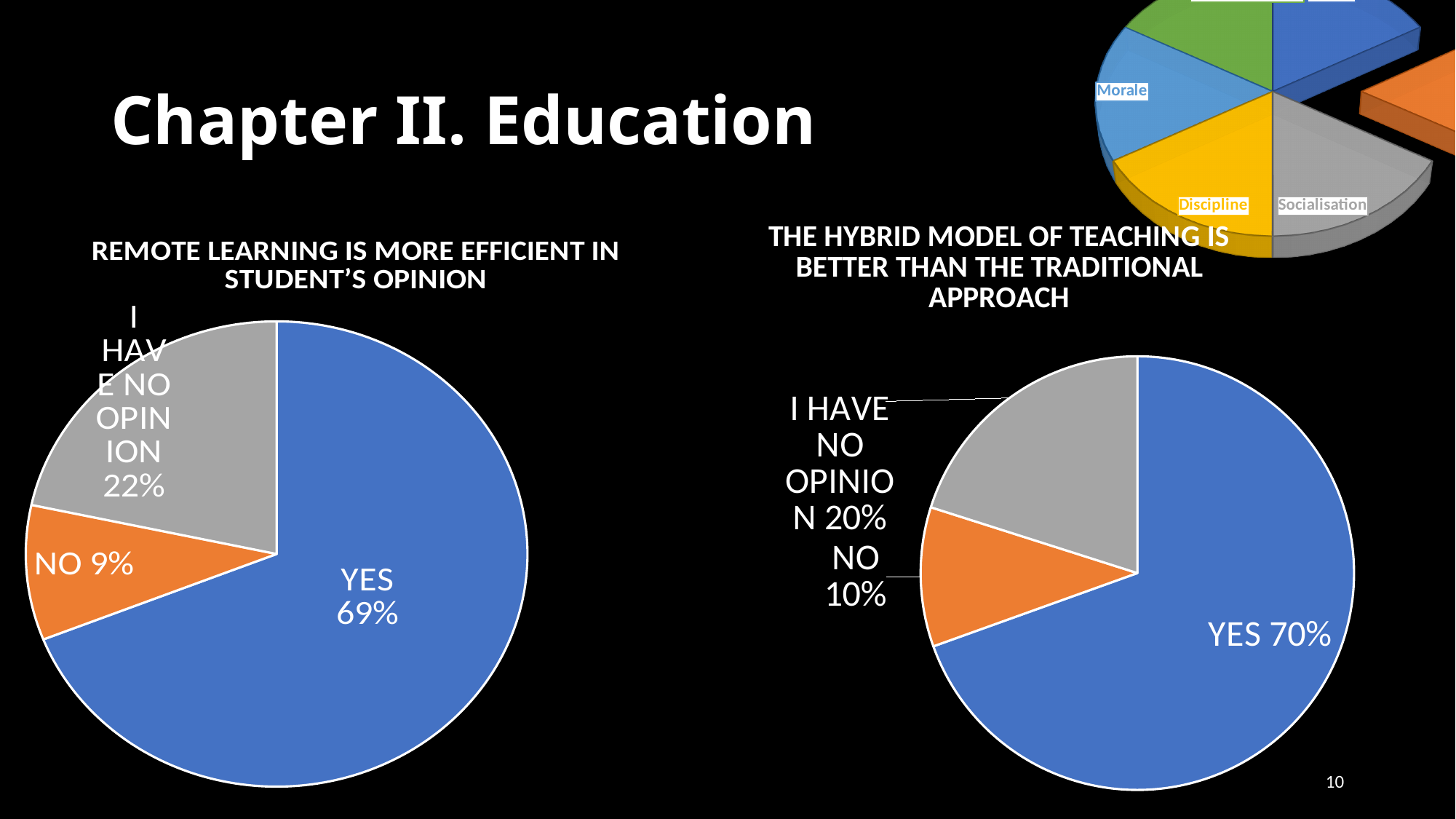
In the chart titled "The hybrid model of teaching is better than the traditional approach", what share of respondents had no opinion? 20% In the chart titled "Remote learning is more efficient in student's opinion", which answer has the smallest slice? NO In the chart titled "The hybrid model of teaching is better than the traditional approach", what share of respondents answered YES? 70% What type of chart is the one titled "The hybrid model of teaching is better than the traditional approach"? Pie chart In the chart titled "Remote learning is more efficient in student's opinion", what share of respondents answered NO? 9% In the chart titled "The hybrid model of teaching is better than the traditional approach", which answer has the largest slice? YES In the chart titled "The hybrid model of teaching is better than the traditional approach", which is larger: the NO slice or the I HAVE NO OPINION slice? I HAVE NO OPINION In the chart titled "Remote learning is more efficient in student's opinion", what share of respondents had no opinion? 22% How many slices does the chart titled "Remote learning is more efficient in student's opinion" have? 3 In the chart titled "Remote learning is more efficient in student's opinion", what is the difference in percentage points between the YES and NO slices? 60 In the chart titled "The hybrid model of teaching is better than the traditional approach", what share of respondents answered NO? 10% In the chart titled "Remote learning is more efficient in student's opinion", what share of respondents answered YES? 69%